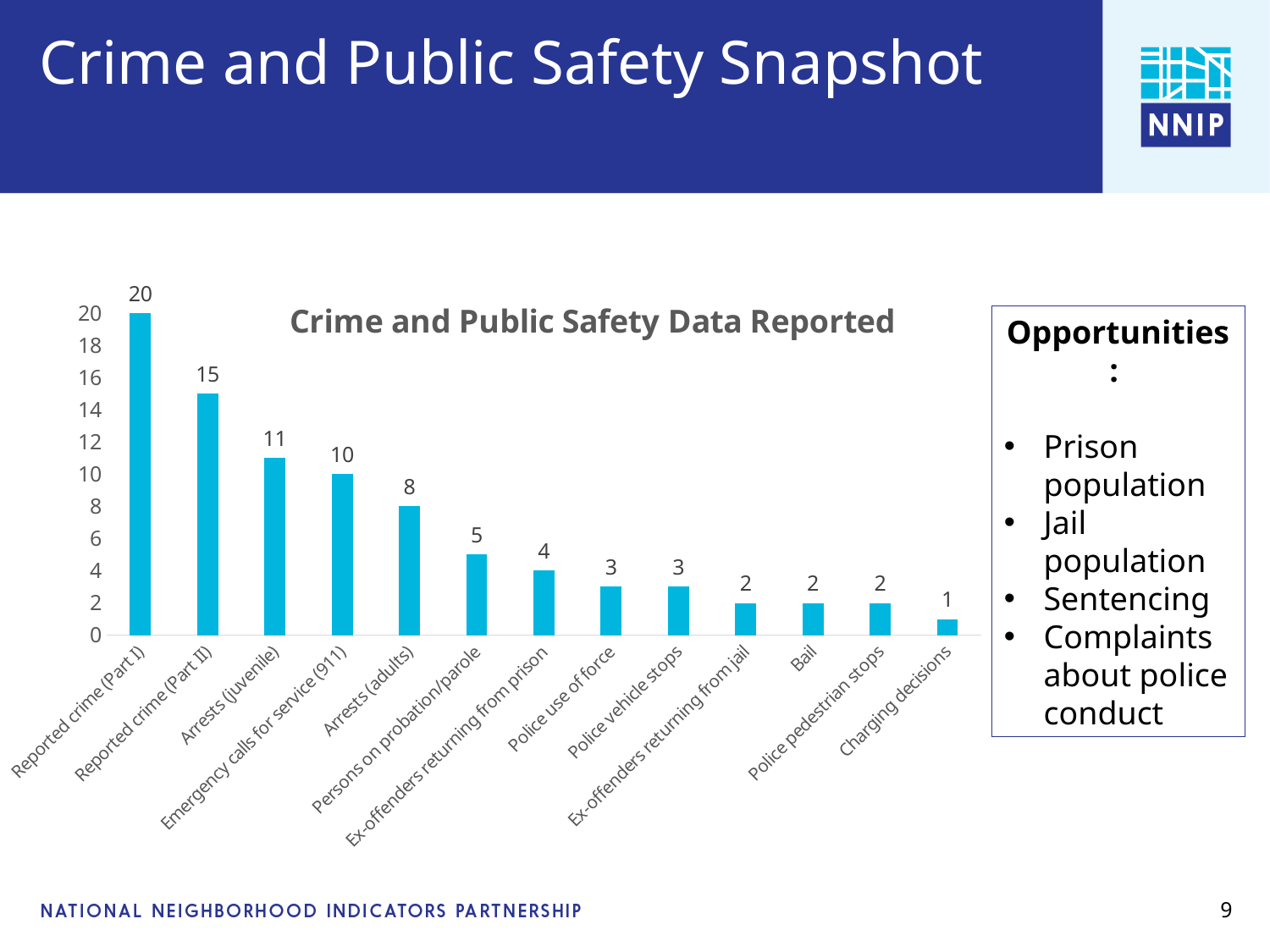
Which category has the highest value? Reported crime (Part I) What kind of chart is this? Bar chart What is the value for Reported crime (Part I)? 20 Which category has the lowest value? Charging decisions What is the value for Persons on probation/parole? 5 What is the value for Charging decisions? 1 What is the title of the chart? Crime and Public Safety Data Reported How many categories are shown on the chart? 13 What is the value for Emergency calls for service (911)? 10 Do the values rise or fall from left to right along the x axis? Fall Which is larger, Arrests (juvenile) or Arrests (adults)? Arrests (juvenile) What is the difference between Reported crime (Part I) and Reported crime (Part II)? 5